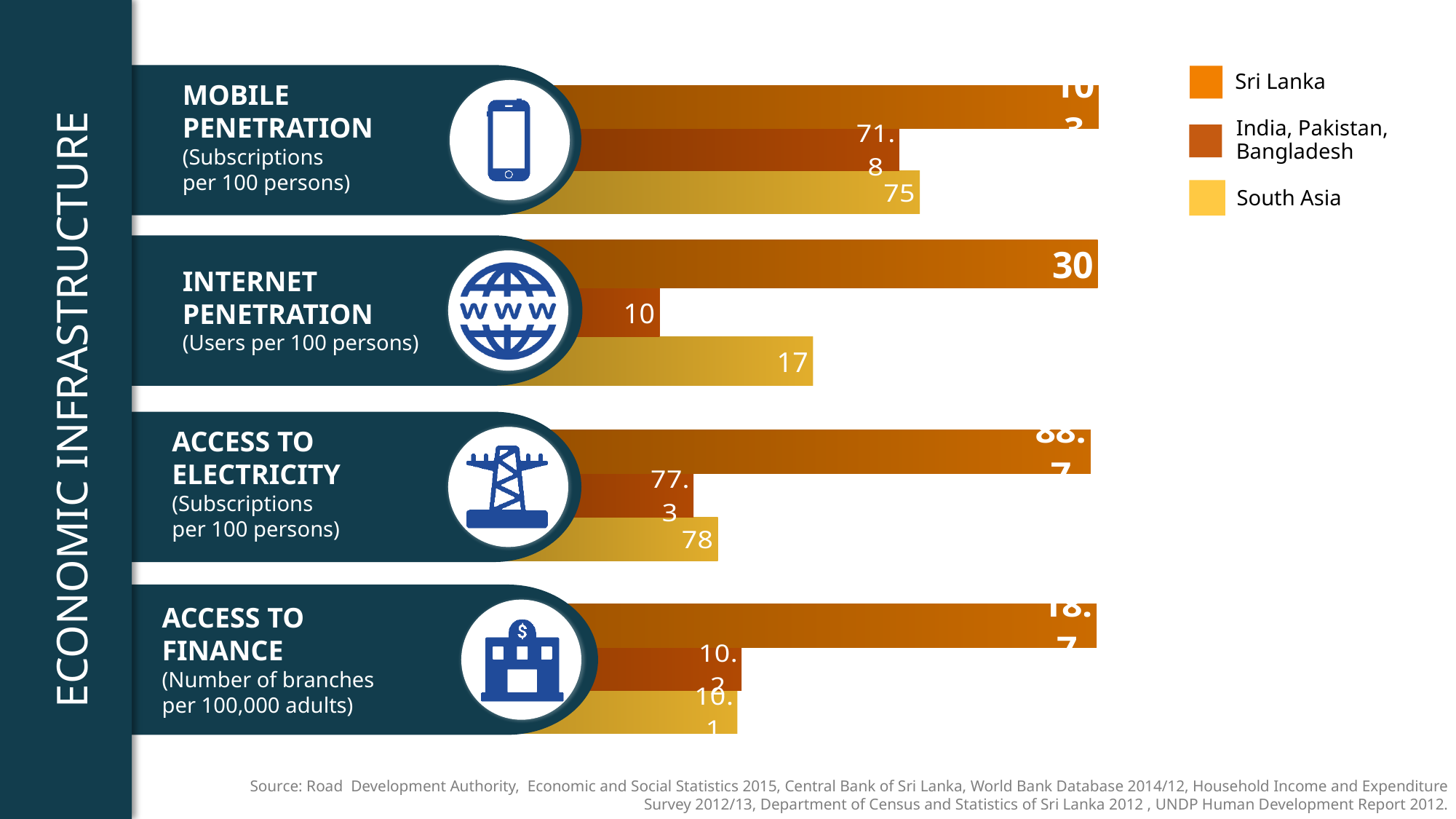
In the Internet Penetration chart, what is the difference between the Sri Lanka value and the South Asia value? 13 How many series does the legend list for the charts on this slide? 3 In the Internet Penetration chart, what is the value for Sri Lanka? 30 In the Internet Penetration chart, what is the value for India, Pakistan, Bangladesh? 10 In the Access to Electricity chart, what is the value for South Asia? 78 In the Access to Electricity chart, what is the value for India, Pakistan, Bangladesh? 77.3 In the Mobile Penetration chart, what is the value for South Asia? 75 In the Access to Finance chart, what is the value for India, Pakistan, Bangladesh? 10.2 In the Mobile Penetration chart, which is larger: the value for South Asia or the value for India, Pakistan, Bangladesh? South Asia In the Internet Penetration chart, which series has the highest value? Sri Lanka In the Internet Penetration chart, what is the value for South Asia? 17 In the Mobile Penetration chart, what is the value for India, Pakistan, Bangladesh? 71.8